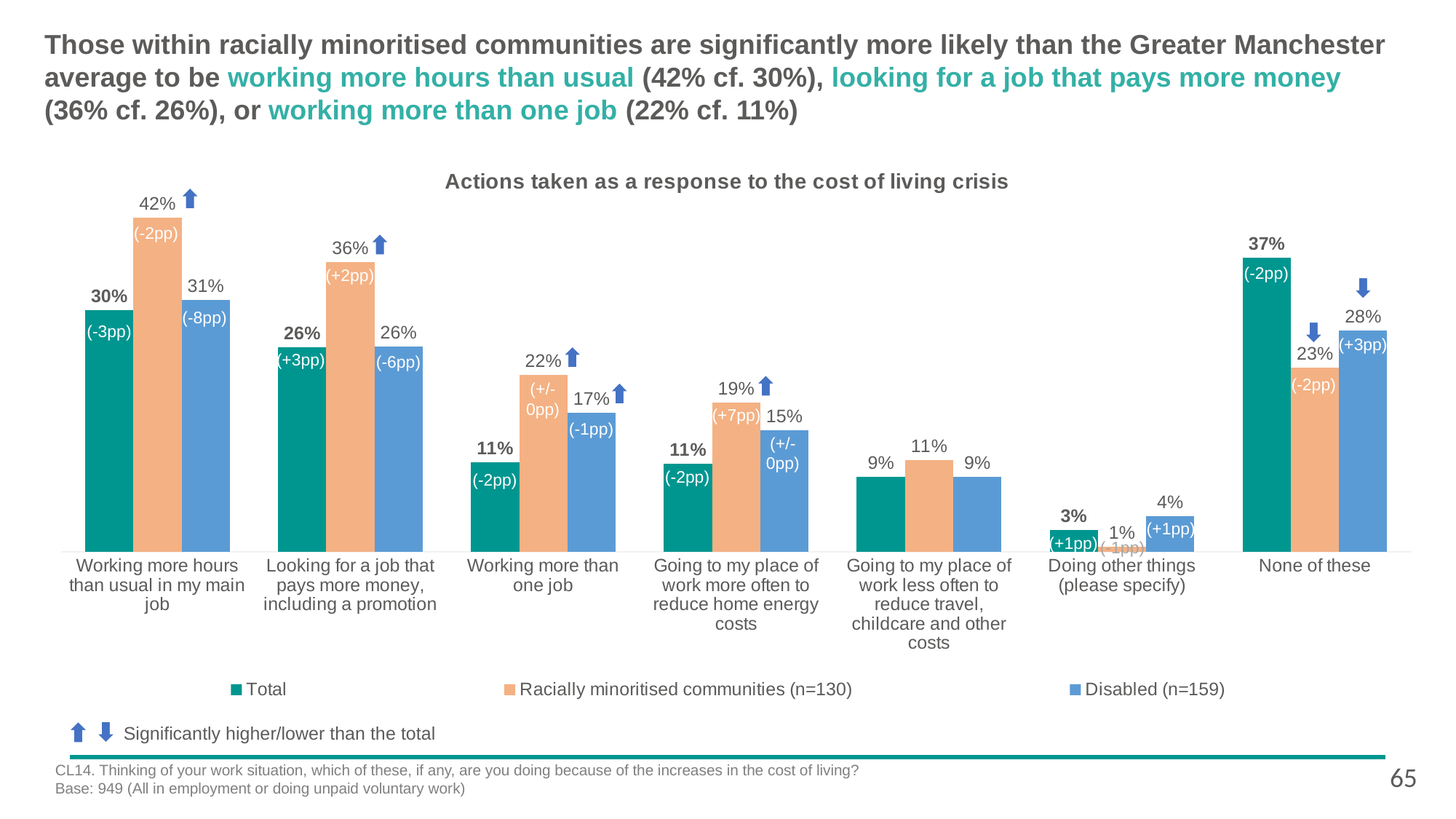
What is the difference between the Racially minoritised communities value and the Total value for 'Working more than one job'? 11% Which category has the highest value for the Disabled series? Working more hours than usual in my main job How many categories are shown on the x axis? 7 What is the value for Disabled for 'Going to my place of work more often to reduce home energy costs'? 15% What is the Total value for 'None of these'? 37% For 'None of these', which is larger: the Total value or the Disabled value? Total How many series does the legend list? 3 What is the value for Racially minoritised communities for 'Working more hours than usual in my main job'? 42% What kind of chart is shown on the slide? Bar chart What is the sample size (n) given in the legend for the Disabled series? 159 What is the title of the chart? Actions taken as a response to the cost of living crisis Which category has the lowest value for the Racially minoritised communities series? Doing other things (please specify)